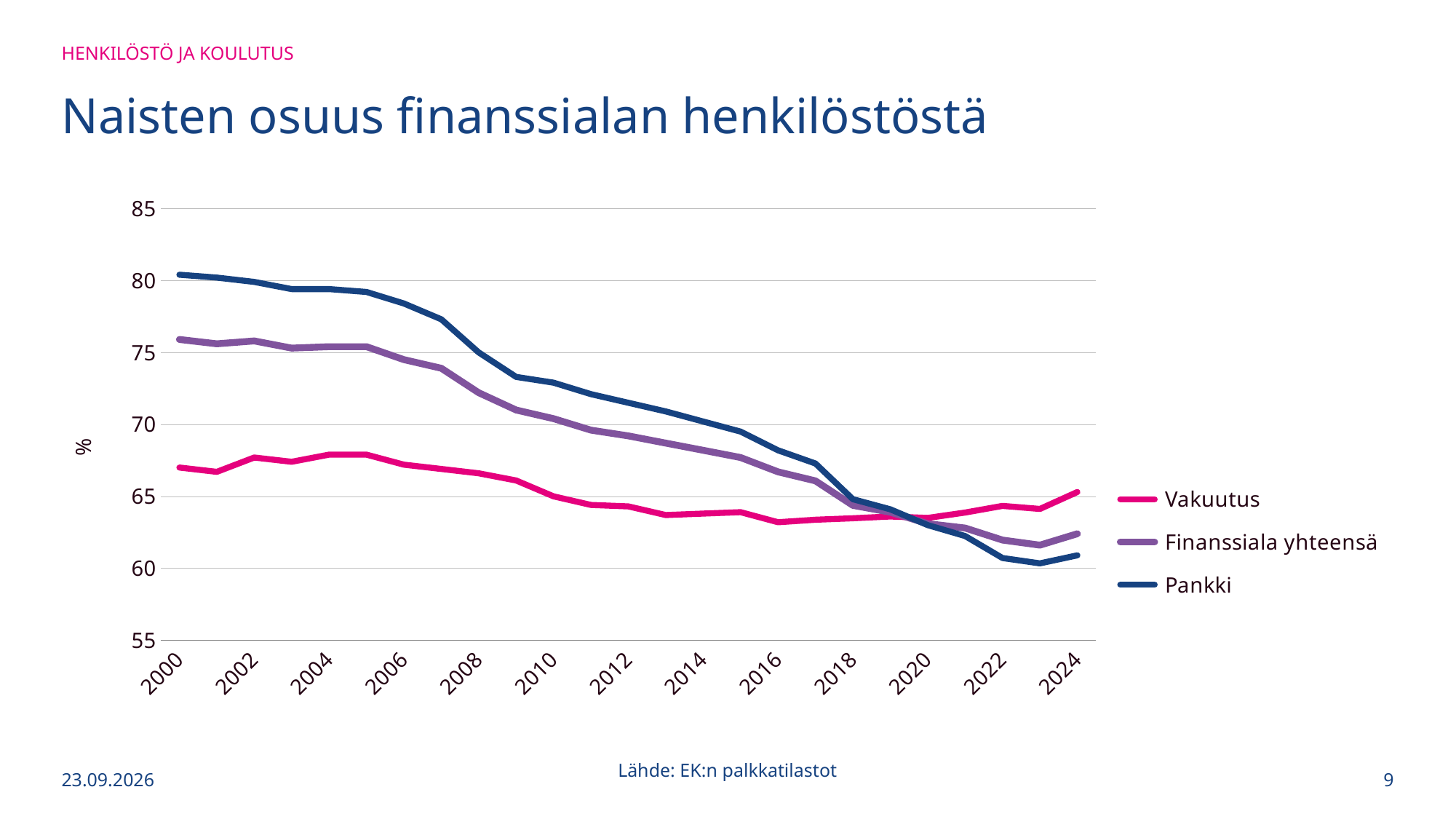
Is the value for Pankki in 2000 greater or less than 75? greater In 2024, which is larger: Vakuutus or Pankki? Vakuutus How many series does the legend list? 3 Is the value for Pankki in 2024 greater or less than 65? less In 2010, which is larger: Finanssiala yhteensä or Vakuutus? Finanssiala yhteensä Which series has the lowest value in 2024? Pankki Which series has the highest value in 2000? Pankki Does the Pankki series rise or fall from 2000 to 2024? fall What kind of chart is shown on the slide? line chart What is the title of the chart? Naisten osuus finanssialan henkilöstöstä Is the value for Vakuutus in 2000 greater or less than 70? less What is the label on the y axis? %